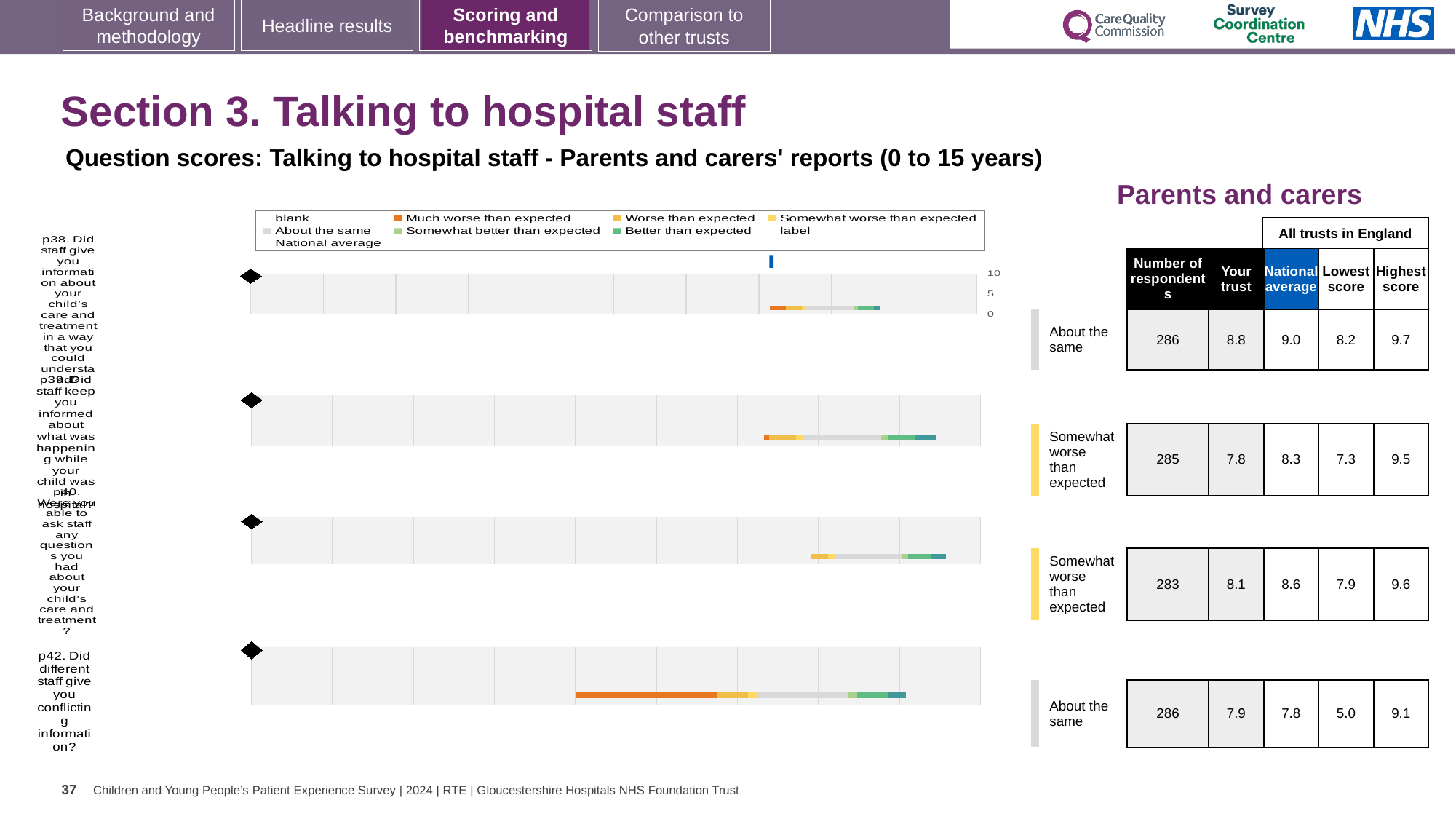
Which question has the lowest 'Lowest score' among all trusts in England? p42 What benchmark category is shown for p39 (Did staff keep you informed about what was happening while your child was in hospital)? Somewhat worse than expected How many question rows (charts) are shown on the slide? 4 What is the highest score among all trusts in England for p40? 9.6 What is the 'Your trust' score for p38 (Did staff give you information about your child's care and treatment in a way that you could understand)? 8.8 What is the national average score for p42 (Did different staff give you conflicting information)? 7.8 How many entries does the chart legend list? 9 How many respondents answered p40 (Were you able to ask staff any questions you had about your child's care and treatment)? 283 Which question has the highest 'Your trust' score? p38 For p42, which is larger: the 'Your trust' score or the national average? Your trust For p39, how much higher is the national average than the 'Your trust' score? 0.5 What kind of chart is used to show the question scores on this slide? Bar chart